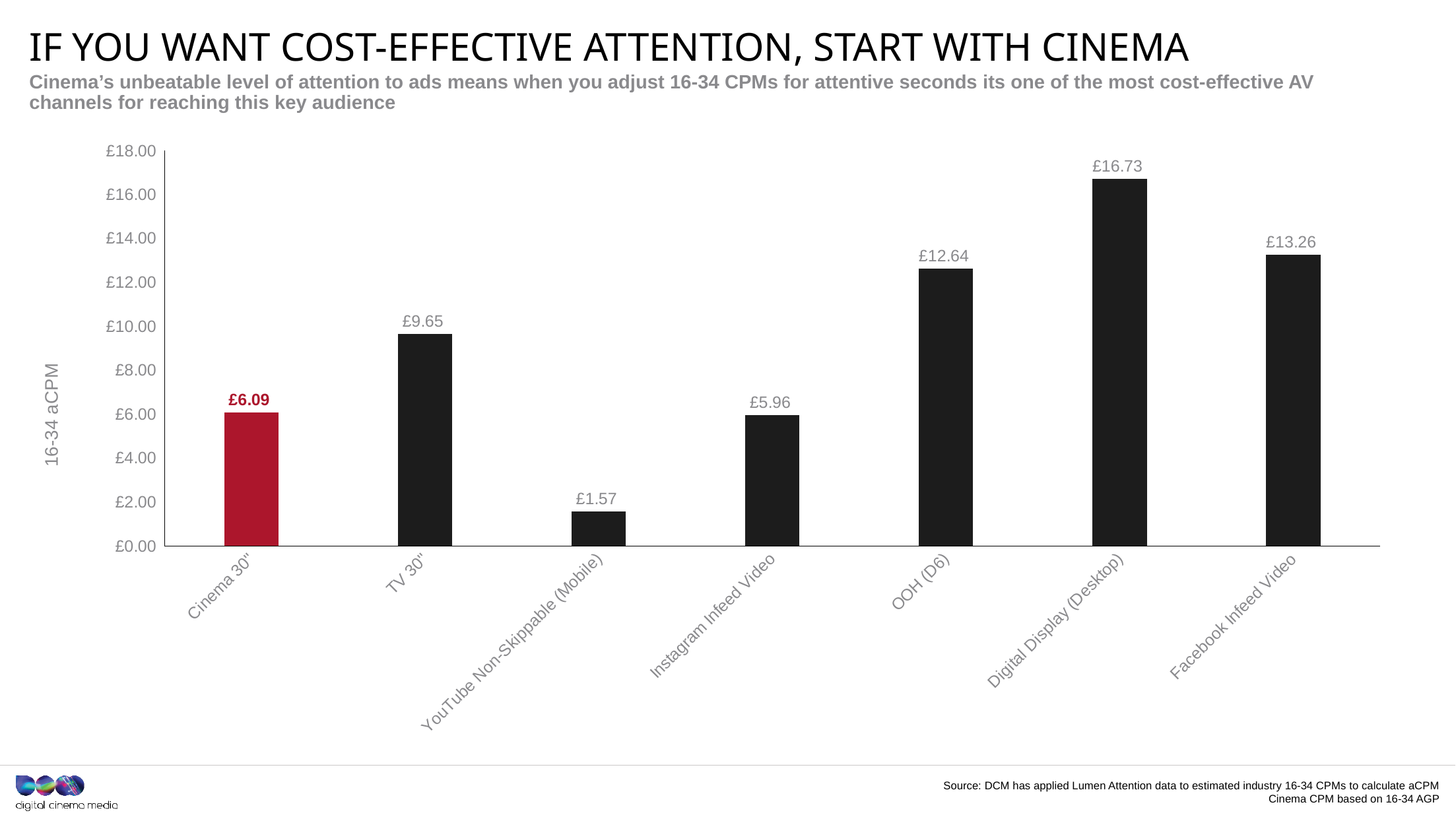
What is the 16-34 aCPM for TV 30"? £9.65 What is the 16-34 aCPM for Facebook Infeed Video? £13.26 Which has a higher 16-34 aCPM, Instagram Infeed Video or Facebook Infeed Video? Facebook Infeed Video What is the 16-34 aCPM for YouTube Non-Skippable (Mobile)? £1.57 Which channel has the lowest 16-34 aCPM? YouTube Non-Skippable (Mobile) Which channel has the highest 16-34 aCPM? Digital Display (Desktop) What is the 16-34 aCPM for Cinema 30"? £6.09 What is the difference in 16-34 aCPM between TV 30" and Cinema 30"? £3.56 What is the difference in 16-34 aCPM between Digital Display (Desktop) and OOH (D6)? £4.09 How many channels are shown in the chart? 7 Is the 16-34 aCPM for OOH (D6) greater or less than £12.00? greater What type of chart is shown on the slide? Bar chart